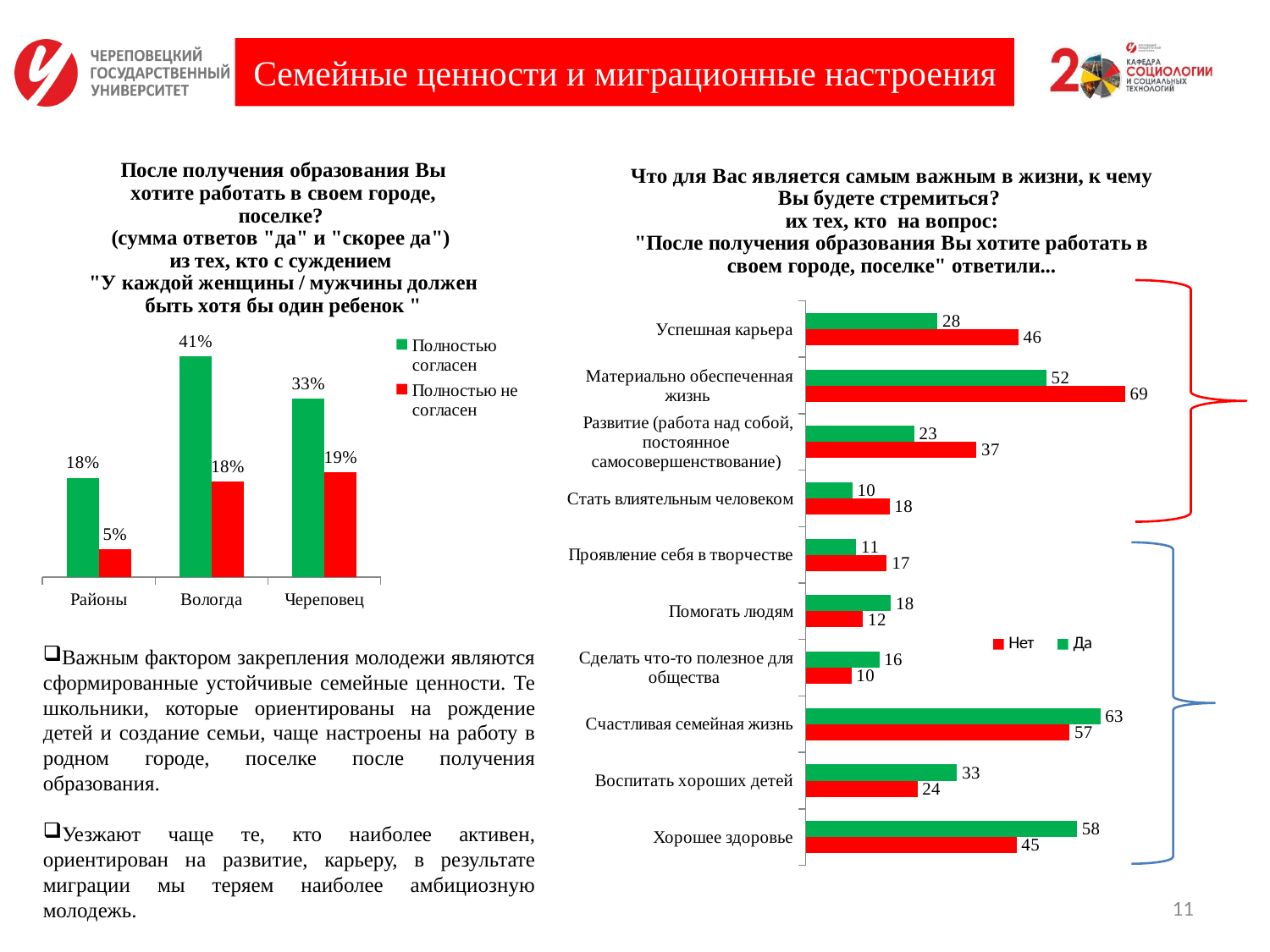
In the left chart, what is the value for Районы in the 'Полностью не согласен' series? 5% In the left chart, what is the value for Вологда in the 'Полностью согласен' series? 41% How many categories are shown in the right chart? 10 In the right chart, which category has the highest 'Нет' value? Материально обеспеченная жизнь In the right chart, what is the 'Да' value for Материально обеспеченная жизнь? 52 In the left chart, what is the difference between the 'Полностью согласен' and 'Полностью не согласен' values for Череповец? 14% In the right chart, what is the 'Нет' value for Хорошее здоровье? 45 In the right chart, which category has the lowest 'Да' value? Стать влиятельным человеком In the right chart, which is larger for Счастливая семейная жизнь: the 'Да' value or the 'Нет' value? Да What kind of chart is the left chart? Bar chart In the left chart, how many series does the legend list? 2 In the left chart, which category has the highest value in the 'Полностью согласен' series? Вологда